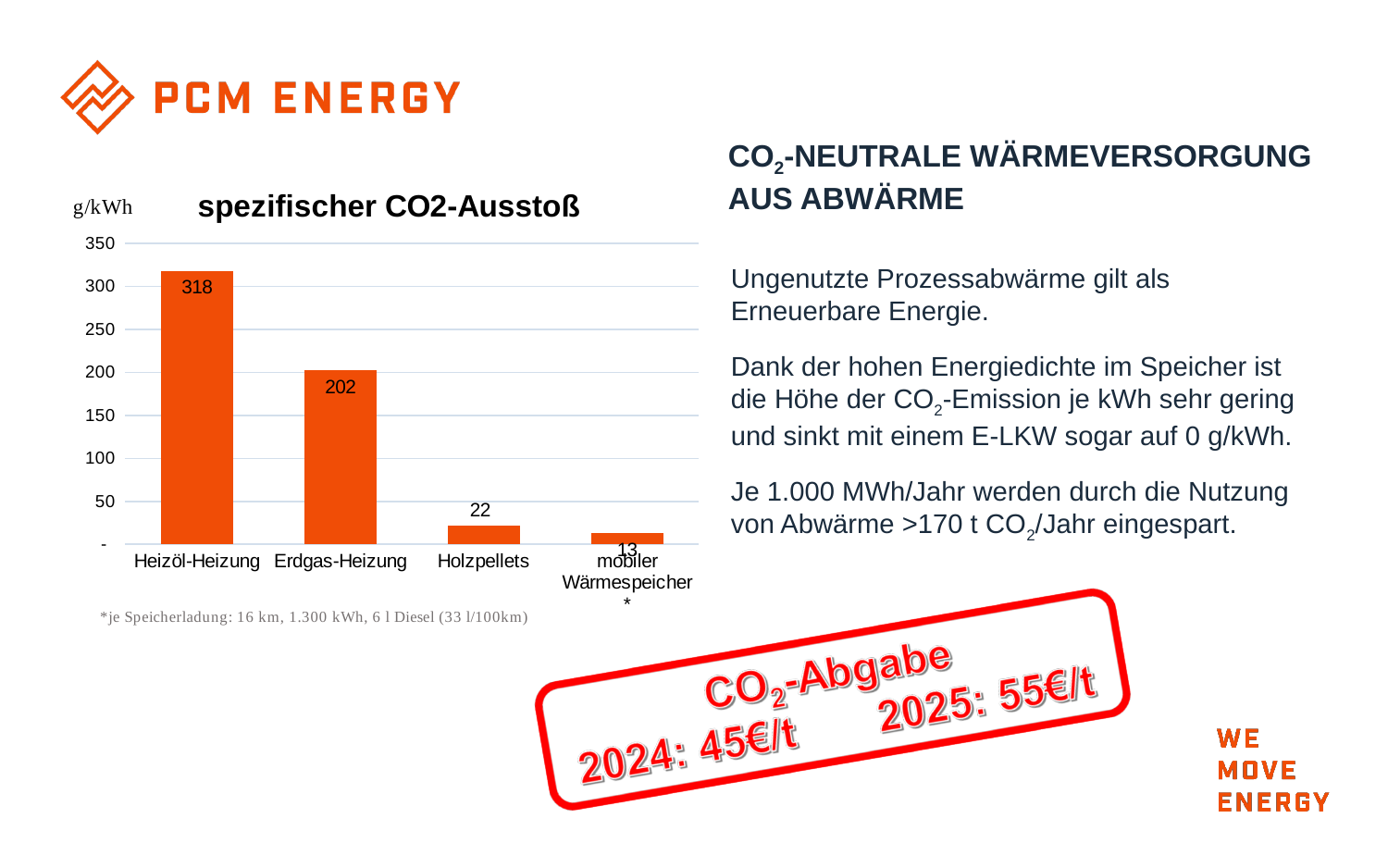
What kind of chart is shown on the slide? bar chart What is the title of the chart? spezifischer CO2-Ausstoß Which category has the highest specific CO2 emission in the chart? Heizöl-Heizung What is the value for Erdgas-Heizung in the chart? 202 What is the difference between the values for Heizöl-Heizung and Erdgas-Heizung? 116 Which is larger, the value for Holzpellets or the value for mobiler Wärmespeicher? Holzpellets What is the value for Holzpellets in the chart? 22 What is the value for Heizöl-Heizung in the chart? 318 How many categories are shown in the chart? 4 Which category has the lowest specific CO2 emission in the chart? mobiler Wärmespeicher What is the difference between the values for Erdgas-Heizung and Holzpellets? 180 Is the value for Erdgas-Heizung greater or less than 250? less